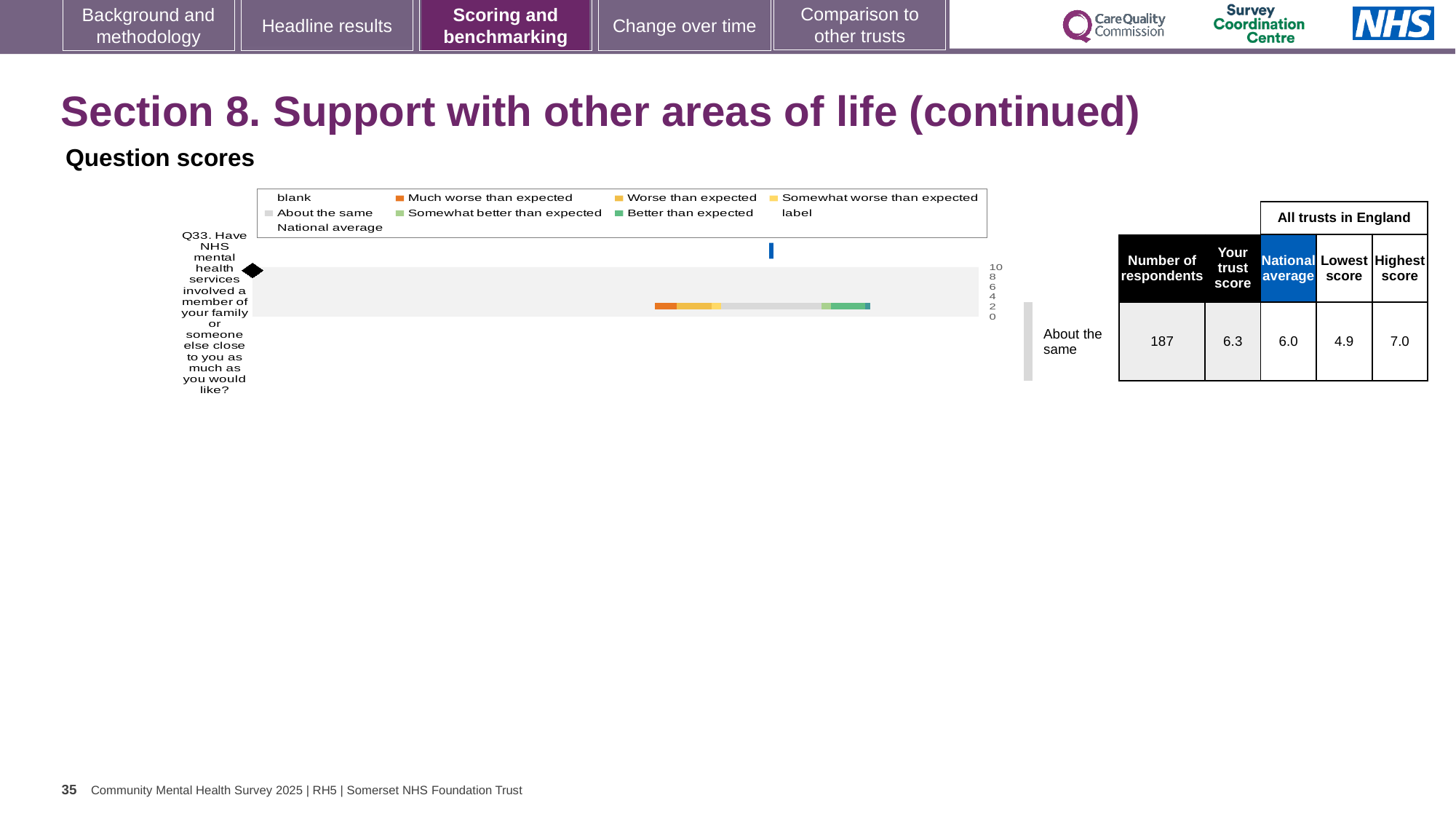
Which benchmark category is the trust's Q33 score placed in? About the same What kind of chart is used to show the Q33 question score? bar chart What is the lowest score among all trusts in England for Q33? 4.9 For Q33, which is larger: the trust score or the national average? the trust score How many entries does the legend of the Question scores chart list? 9 What is the highest score among all trusts in England for Q33? 7.0 What is the national average for Q33 shown next to the chart? 6.0 Which question number is shown in the Question scores chart? Q33 What is the trust score for Q33 shown next to the chart? 6.3 How many respondents answered Q33? 187 How many questions are plotted in the Question scores chart? 1 What is the difference between the highest and lowest scores for Q33 across all trusts in England? 2.1